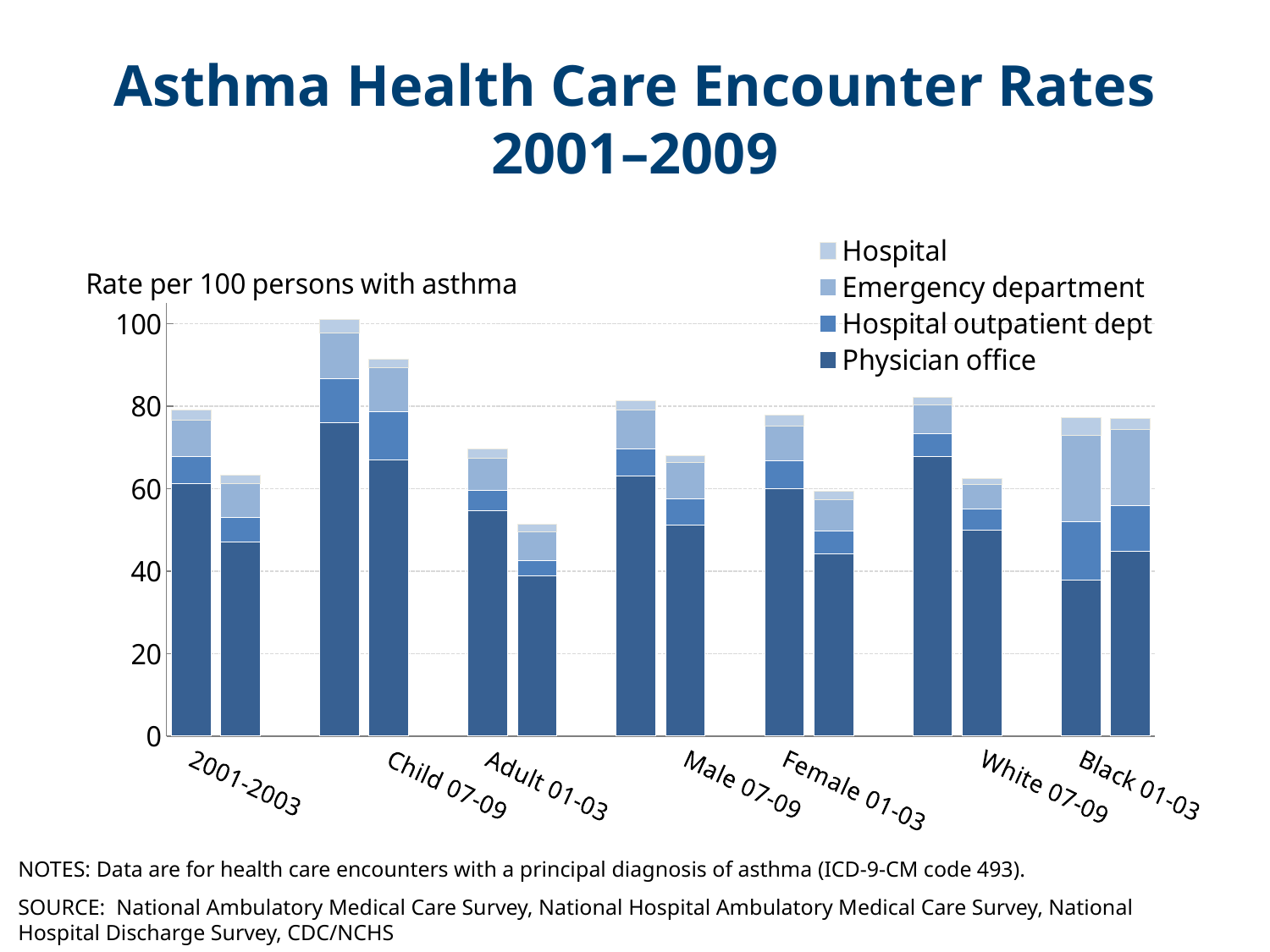
What is the y-axis label of the chart? Rate per 100 persons with asthma How many series does the legend list? 4 Is the total of the tallest stacked bar greater or less than 80? greater How many stacked bars are plotted in the chart? 14 Is the total of the shortest stacked bar greater or less than 40? greater Is the total of the shortest stacked bar greater or less than 60? less What are the four series listed in the legend? Hospital, Emergency department, Hospital outpatient dept, Physician office What kind of chart is shown on the slide? stacked bar chart